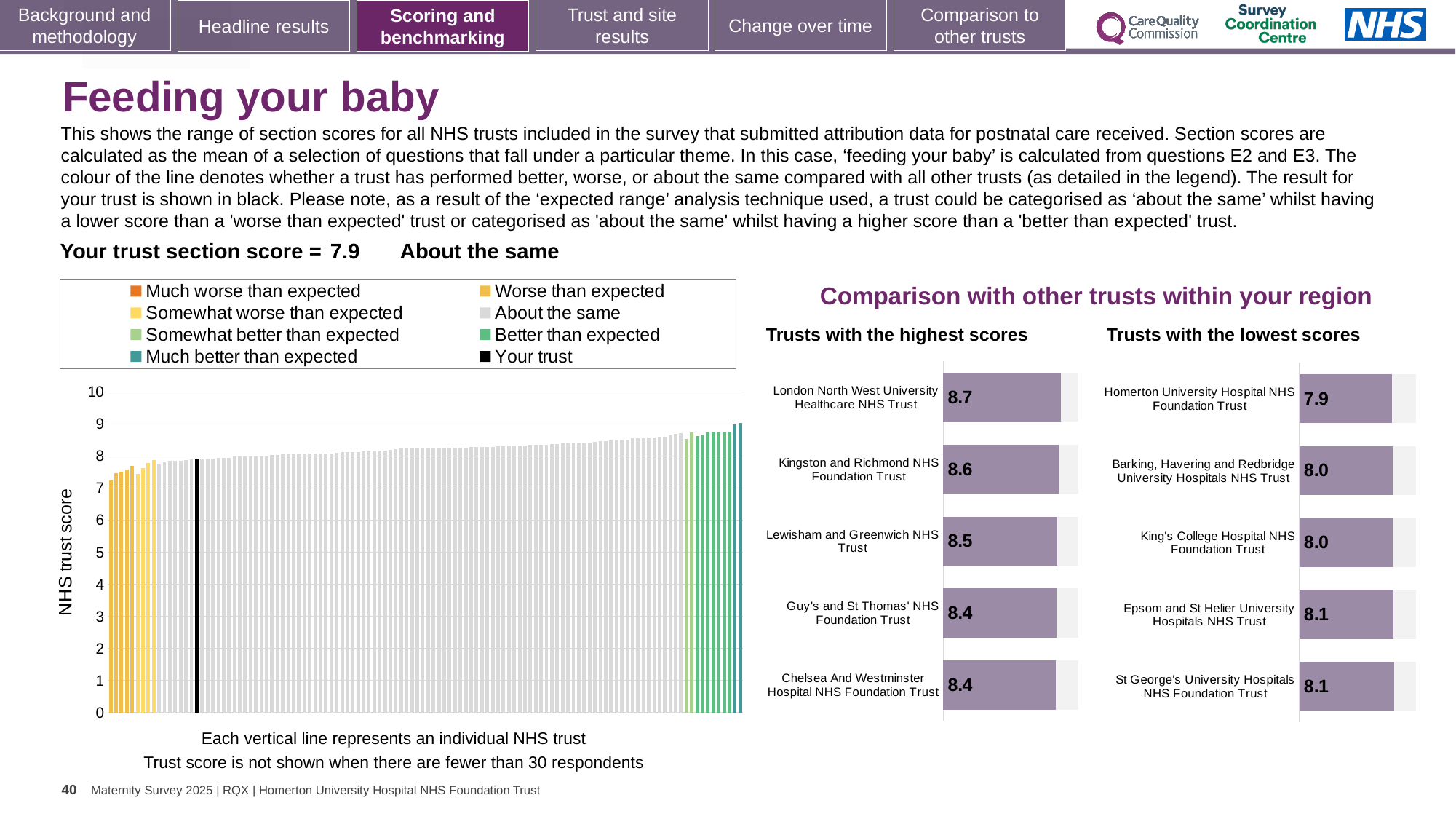
In the 'Trusts with the highest scores' chart, what is the score for Lewisham and Greenwich NHS Trust? 8.5 How many entries does the legend of the main 'NHS trust score' chart list? 8 In the 'Trusts with the highest scores' chart, what is the difference between the scores of London North West University Healthcare NHS Trust and Kingston and Richmond NHS Foundation Trust? 0.1 How many trusts are shown in the 'Trusts with the lowest scores' chart? 5 In the 'Trusts with the lowest scores' chart, what is the score for Epsom and St Helier University Hospitals NHS Trust? 8.1 In the 'Trusts with the lowest scores' chart, what is the score for Homerton University Hospital NHS Foundation Trust? 7.9 In the 'Trusts with the highest scores' chart, which trust has the highest score? London North West University Healthcare NHS Trust What kind of chart is the main chart with the 'NHS trust score' axis? Bar chart In the 'Trusts with the highest scores' chart, what is the score for London North West University Healthcare NHS Trust? 8.7 In the 'Trusts with the lowest scores' chart, which has the larger score: Homerton University Hospital NHS Foundation Trust or St George's University Hospitals NHS Foundation Trust? St George's University Hospitals NHS Foundation Trust In the main 'NHS trust score' chart, do the bar values rise or fall from left to right? Rise In the 'Trusts with the lowest scores' chart, which trust has the lowest score? Homerton University Hospital NHS Foundation Trust